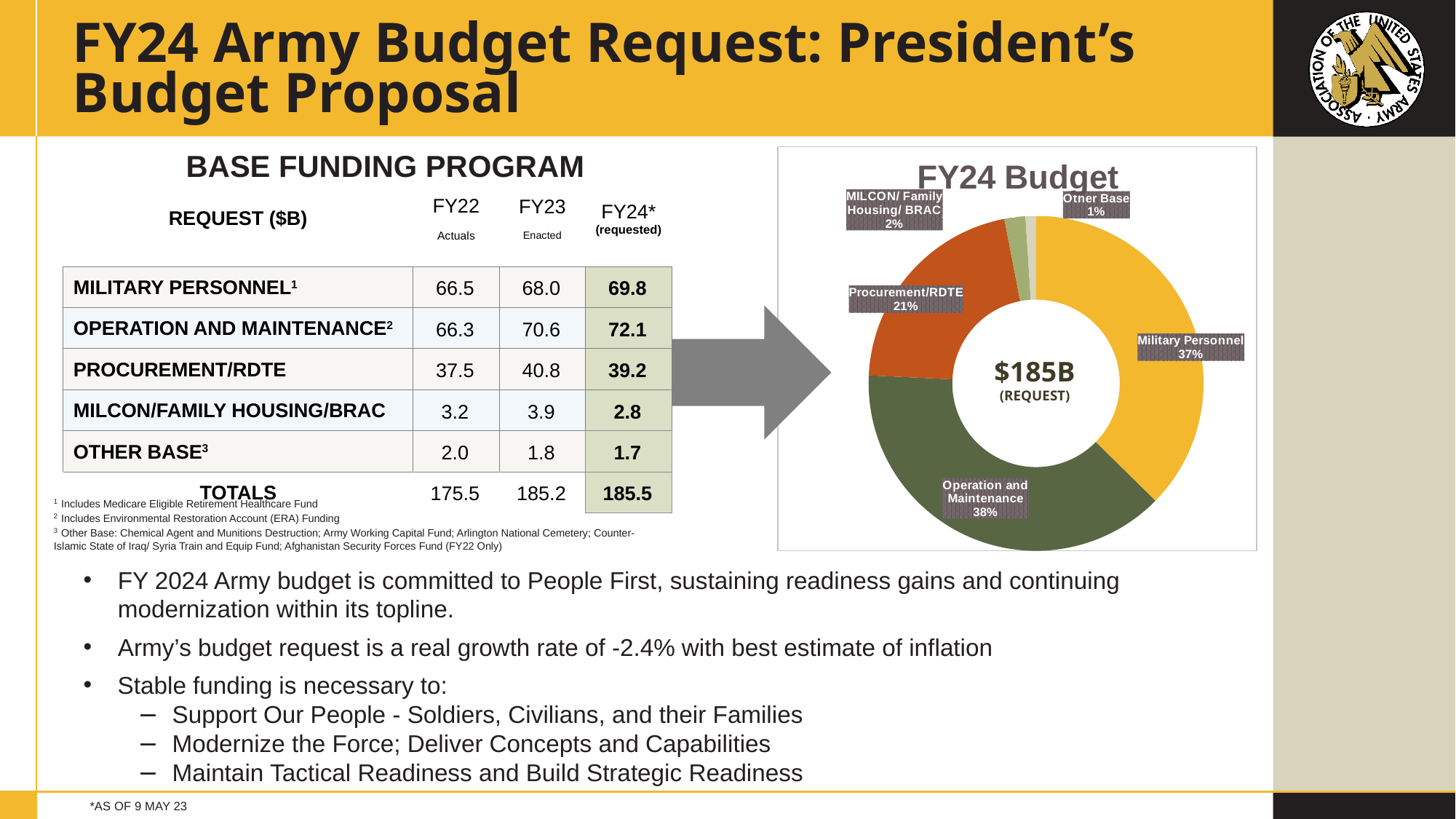
In the FY24 Budget chart, what share does Operation and Maintenance have? 38% In the FY24 Budget chart, what share does MILCON/Family Housing/BRAC have? 2% In the FY24 Budget chart, which category has the largest share? Operation and Maintenance In the FY24 Budget chart, what share does Procurement/RDTE have? 21% What is the title of the chart on the right of the slide? FY24 Budget In the FY24 Budget chart, which category has the smallest share? Other Base In the FY24 Budget chart, what is the difference in share between Military Personnel and Procurement/RDTE? 16% What total request amount is shown in the center of the FY24 Budget chart? $185B In the FY24 Budget chart, what share does Other Base have? 1% In the FY24 Budget chart, how many slices are there? 5 In the FY24 Budget chart, what share does Military Personnel have? 37% What kind of chart is the FY24 Budget chart? Pie chart (donut)